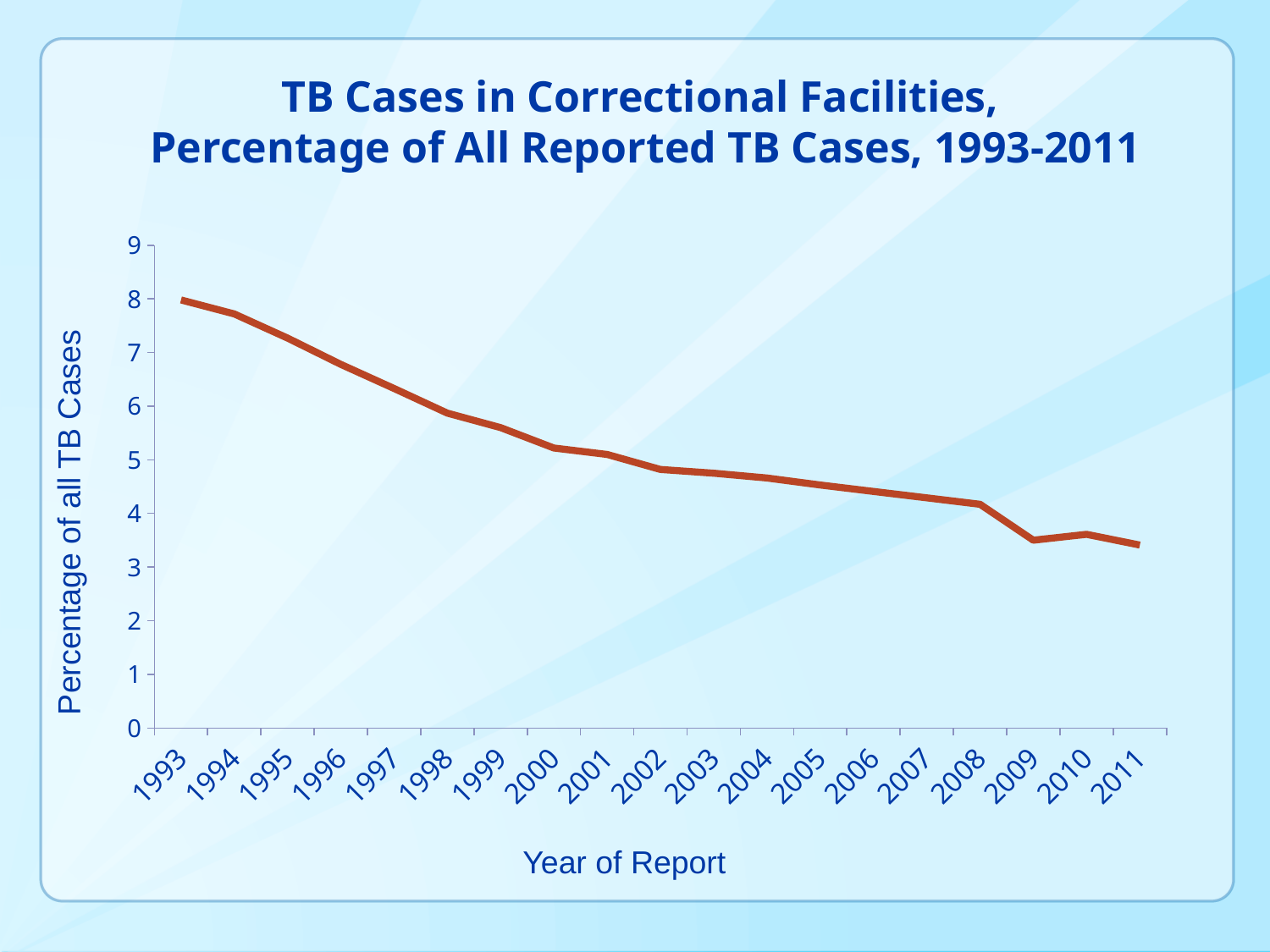
Is the value for 1996 greater or less than 7? less How many years are plotted along the x axis? 19 Is the value for 2011 greater or less than 4? less Which year has the highest percentage of all TB cases? 1993 Which year has the larger value, 1997 or 2003? 1997 What is the label of the y axis? Percentage of all TB Cases What kind of chart is shown on the slide? line chart Do the values rise or fall from 1993 to 2011? fall Is the value for 1993 greater or less than 7? greater What is the label of the x axis? Year of Report